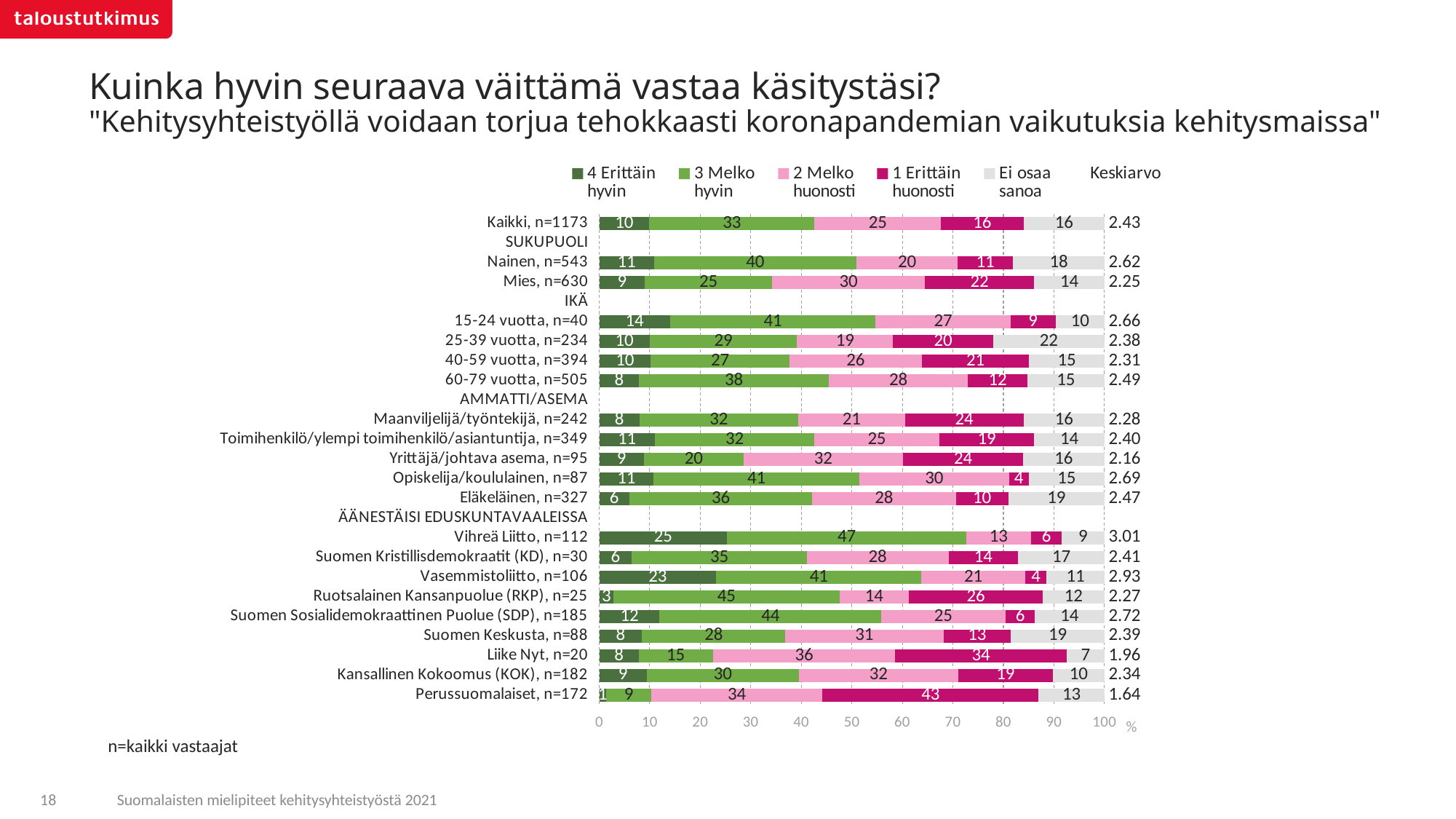
Which response category does the dark green colour represent in the legend? 4 Erittäin hyvin What is the Keskiarvo (mean) shown for Vihreä Liitto, n=112? 3.01 What percentage of Perussuomalaiset, n=172 answered "1 Erittäin huonosti"? 43 What is the difference in the "3 Melko hyvin" share between Nainen, n=543 and Mies, n=630? 15 What percentage of 15-24 vuotta, n=40 answered "3 Melko hyvin"? 41 Which group has the highest Keskiarvo value? Vihreä Liitto, n=112 What percentage of Liike Nyt, n=20 answered "Ei osaa sanoa"? 7 Which group has the highest share of "4 Erittäin hyvin" answers? Vihreä Liitto, n=112 Which group has the lowest Keskiarvo value? Perussuomalaiset, n=172 What kind of chart is shown on the slide? Stacked horizontal bar chart Which has the higher Keskiarvo, Nainen, n=543 or Mies, n=630? Nainen, n=543 What percentage of all respondents (Kaikki, n=1173) answered "3 Melko hyvin"? 33